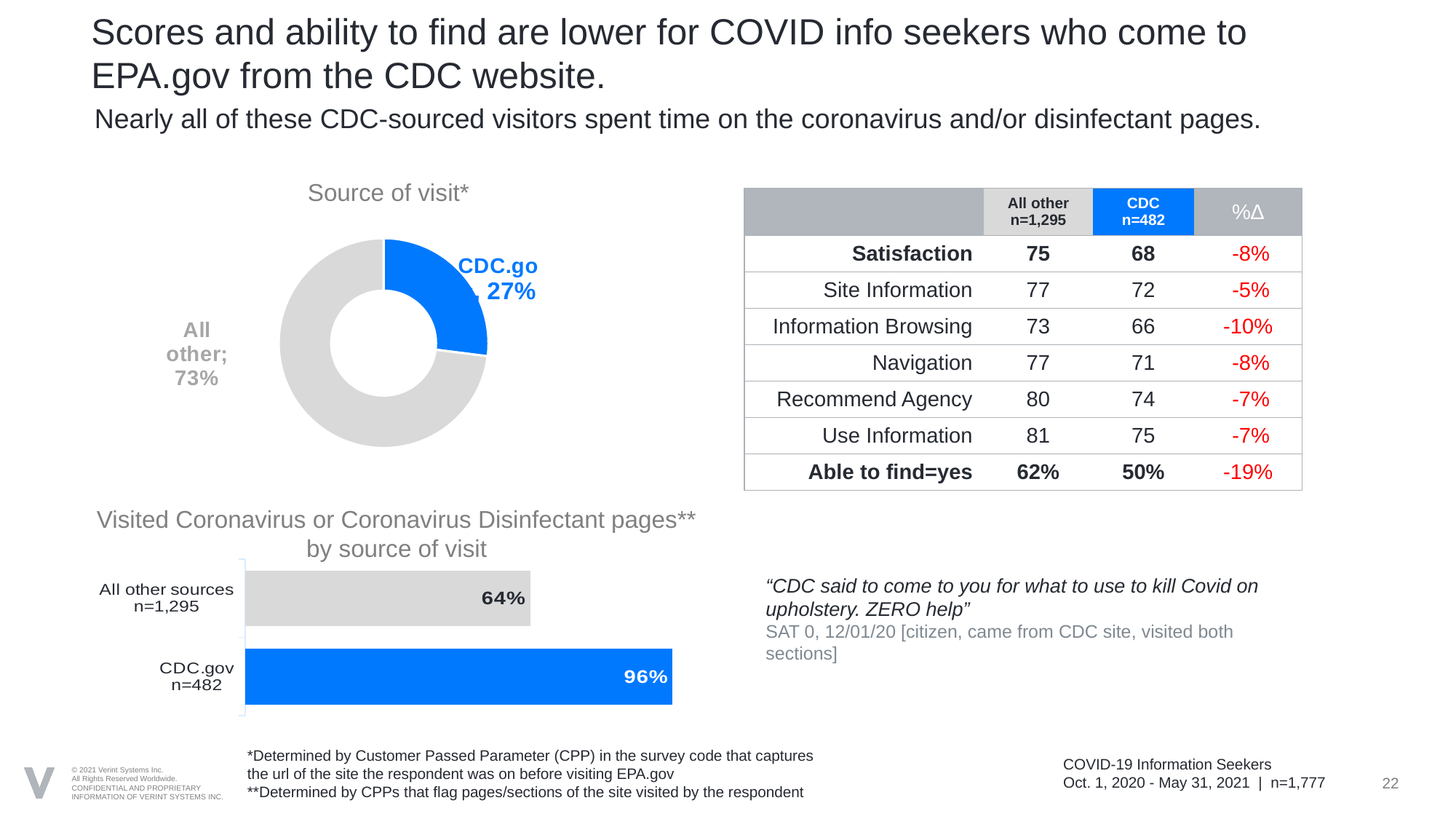
In the 'Visited Coronavirus or Coronavirus Disinfectant pages by source of visit' chart, what is the value for CDC.gov? 96% How many bars are in the 'Visited Coronavirus or Coronavirus Disinfectant pages by source of visit' chart? 2 In the 'Visited Coronavirus or Coronavirus Disinfectant pages by source of visit' chart, which source has the higher value? CDC.gov In the 'Source of visit' chart, what colour is the CDC.gov slice? Blue What kind of chart is the 'Visited Coronavirus or Coronavirus Disinfectant pages by source of visit' chart? Bar chart In the 'Source of visit' chart, which slice is larger, CDC.gov or All other? All other In the 'Source of visit' chart, what share of visits came from all other sources? 73% What kind of chart is the 'Source of visit' chart? Donut (pie) chart In the 'Visited Coronavirus or Coronavirus Disinfectant pages by source of visit' chart, what is the value for All other sources? 64% How many slices does the 'Source of visit' chart have? 2 In the 'Visited Coronavirus or Coronavirus Disinfectant pages by source of visit' chart, what is the difference between the CDC.gov value and the All other sources value? 32 percentage points In the 'Source of visit' chart, what share of visits came from CDC.gov? 27%